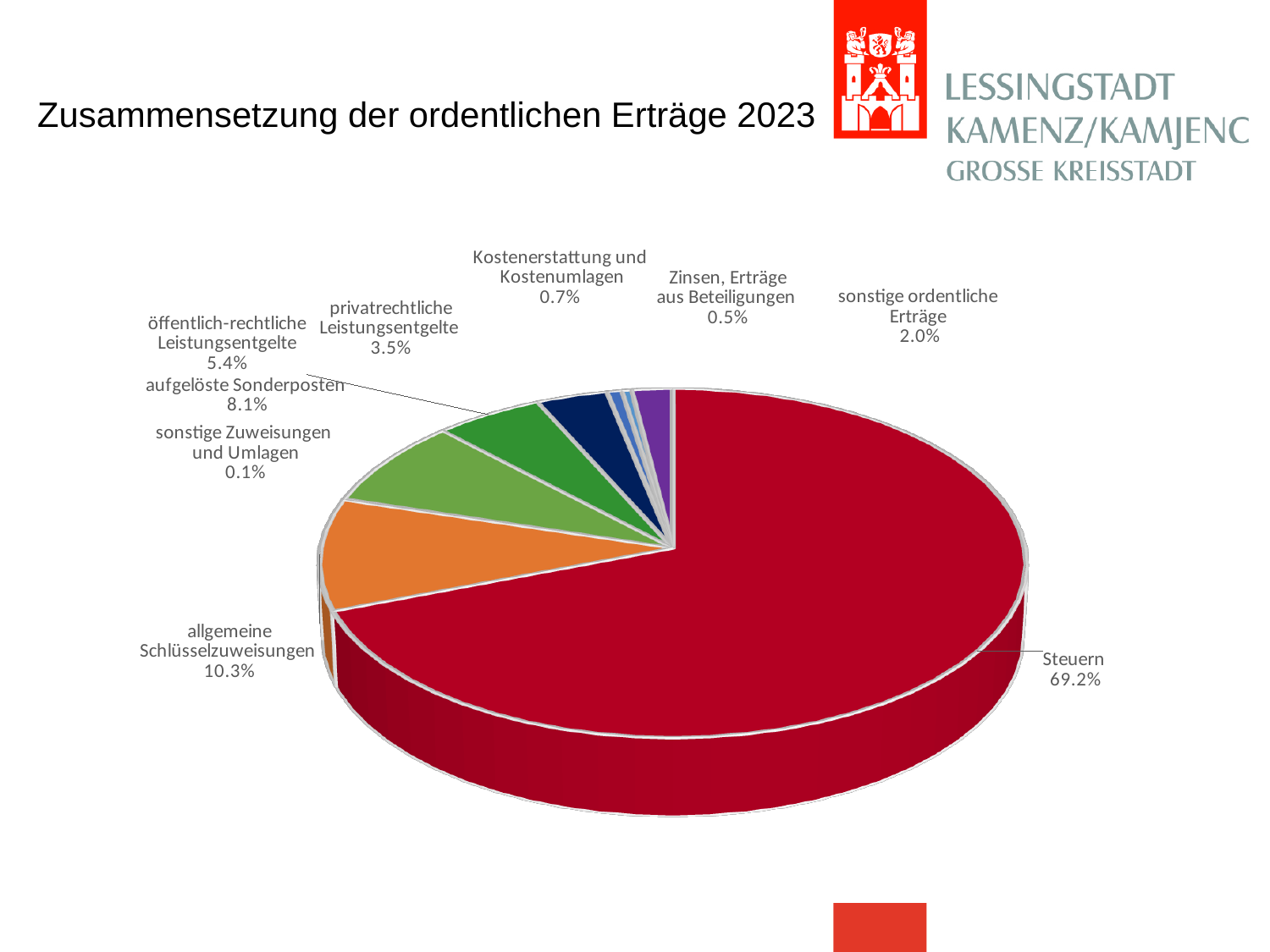
How many categories are shown in the pie chart? 9 What is the difference in percentage points between allgemeine Schlüsselzuweisungen and aufgelöste Sonderposten? 2.2 What share of the pie does Steuern account for? 69.2% What percentage is shown for allgemeine Schlüsselzuweisungen? 10.3% Which category has the smallest share of the pie? sonstige Zuweisungen und Umlagen What is the title of the slide? Zusammensetzung der ordentlichen Erträge 2023 What percentage is shown for aufgelöste Sonderposten? 8.1% Which category has the largest share of the pie? Steuern What type of chart is shown on the slide? pie chart What percentage is shown for öffentlich-rechtliche Leistungsentgelte? 5.4% Which is larger: privatrechtliche Leistungsentgelte or öffentlich-rechtliche Leistungsentgelte? öffentlich-rechtliche Leistungsentgelte What percentage is shown for sonstige ordentliche Erträge? 2.0%